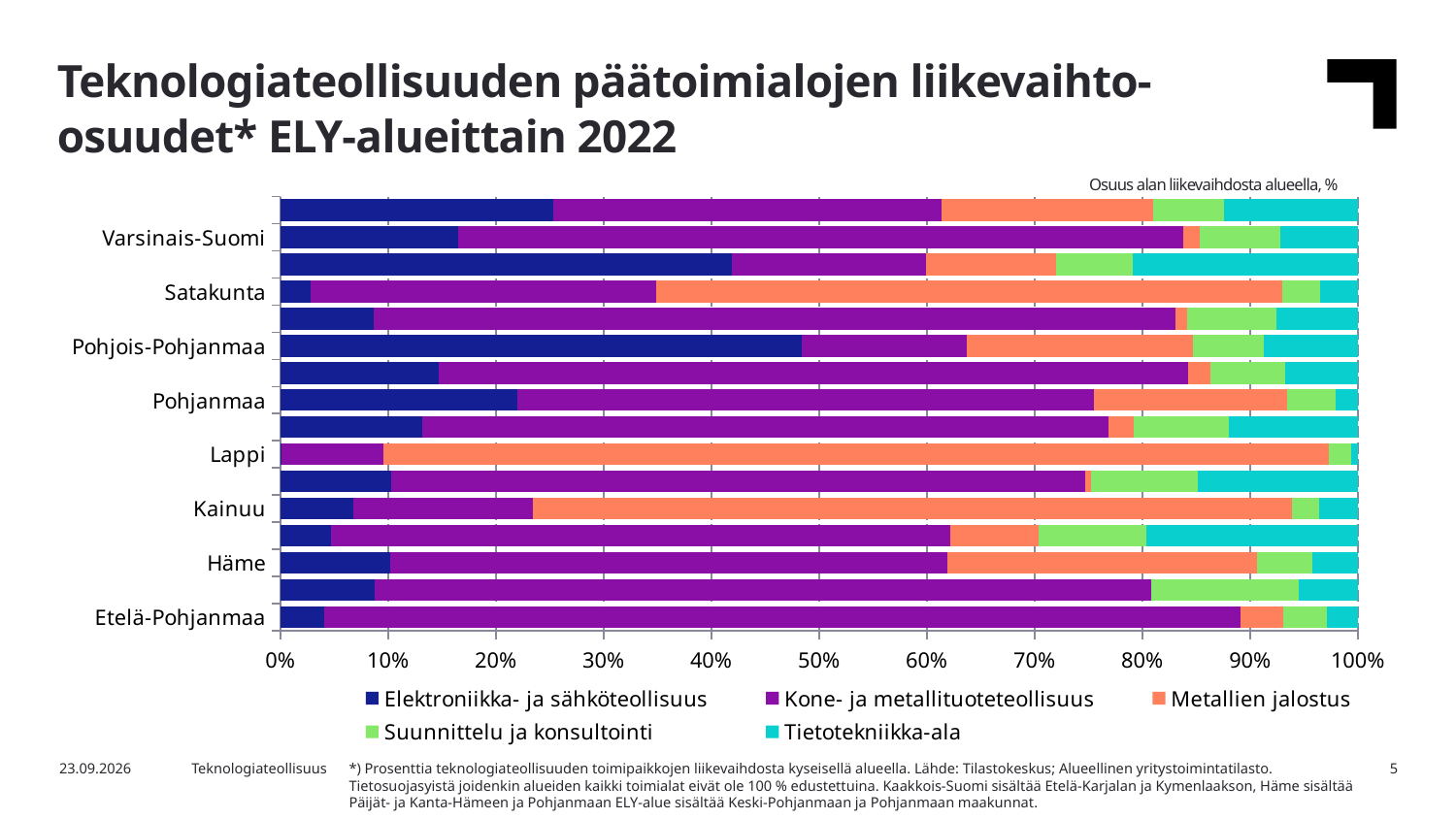
Which series has the largest share in the Lappi bar? Metallien jalostus Is the share of Metallien jalostus for Satakunta greater or less than 50%? greater Is the share of Kone- ja metallituoteteollisuus for Etelä-Pohjanmaa greater or less than 80%? greater Is the share of Elektroniikka- ja sähköteollisuus for Pohjois-Pohjanmaa greater or less than 40%? greater Which series is shown in orange in the legend? Metallien jalostus Which has the larger share of Elektroniikka- ja sähköteollisuus, Pohjois-Pohjanmaa or Satakunta? Pohjois-Pohjanmaa What kind of chart is shown on the slide? Stacked bar chart How many series does the legend list? 5 How many region labels are shown on the vertical axis of the chart? 8 What is the highest value shown on the horizontal axis? 100%